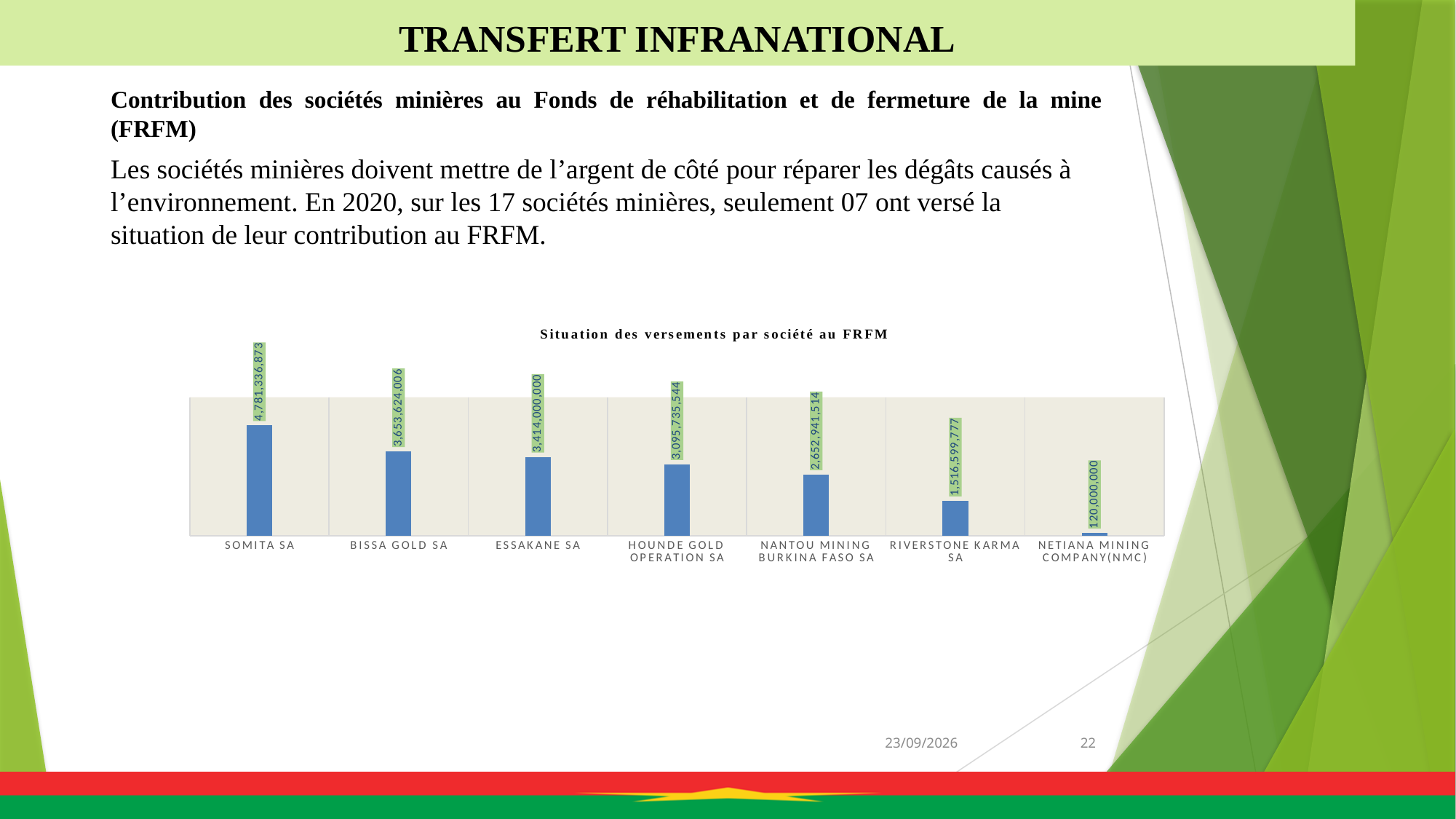
What is the value for SOMITA SA in the chart 'Situation des versements par société au FRFM'? 4,781,336,873 What is the difference between the values for HOUNDE GOLD OPERATION SA and NANTOU MINING BURKINA FASO SA? 442,794,030 How many companies are shown in the chart? 7 What is the value for RIVERSTONE KARMA SA? 1,516,599,777 What is the difference between the values for SOMITA SA and BISSA GOLD SA? 1,127,712,867 What kind of chart is shown on the slide? Bar chart Which is larger, the value for BISSA GOLD SA or the value for ESSAKANE SA? BISSA GOLD SA What is the value for NETIANA MINING COMPANY(NMC)? 120,000,000 Which company has the highest value in the chart? SOMITA SA Do the values rise or fall from left to right across the chart? Fall What is the value for ESSAKANE SA? 3,414,000,000 Which company has the lowest value in the chart? NETIANA MINING COMPANY(NMC)